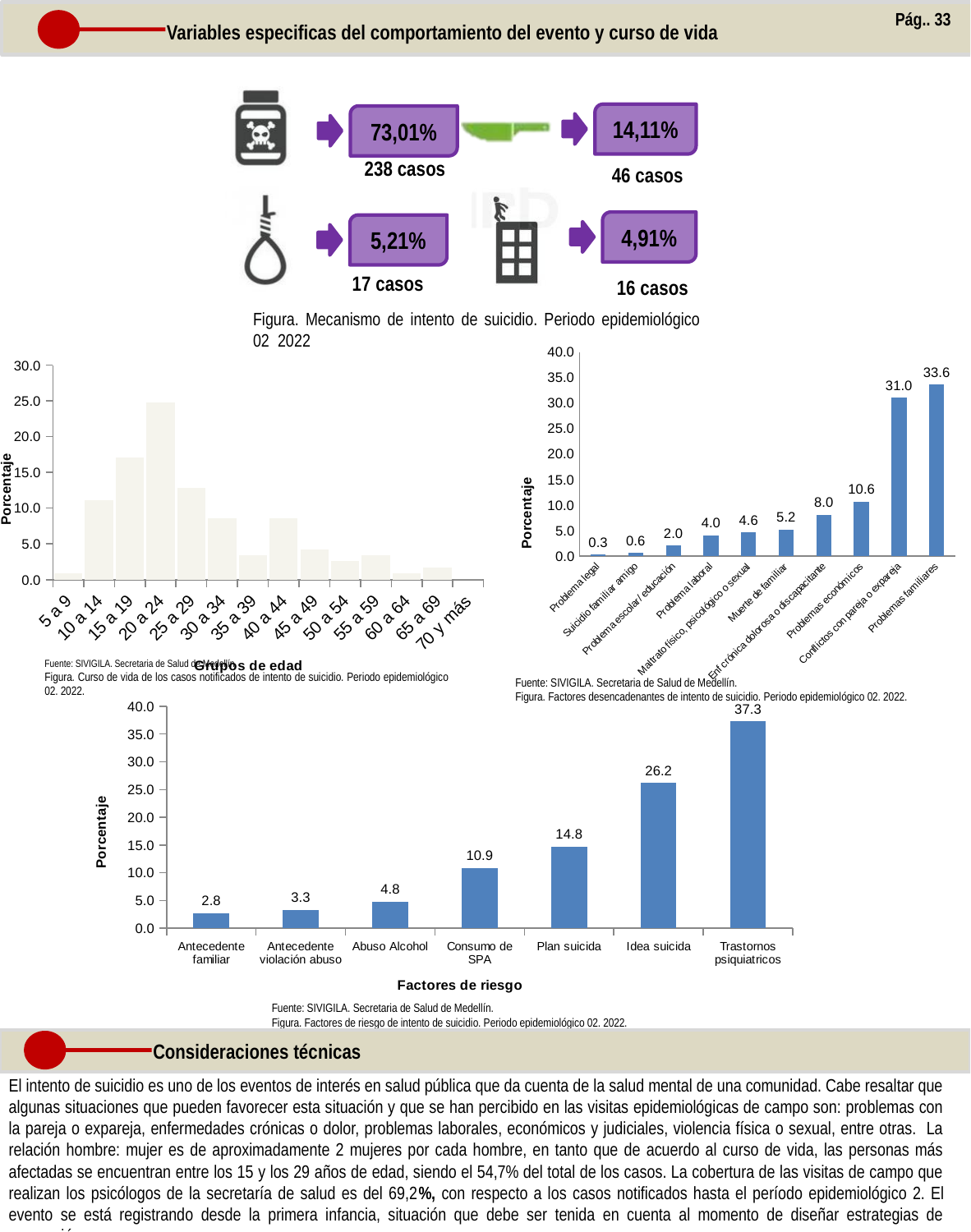
In the chart titled 'Curso de vida de los casos notificados de intento de suicidio' (left), which age group has the highest value? 20 a 24 In the chart titled 'Factores desencadenantes de intento de suicidio' (right), what is the value for 'Problemas familiares'? 33.6 In the chart titled 'Factores desencadenantes de intento de suicidio' (right), what is the value for 'Problemas económicos'? 10.6 In the chart titled 'Factores de riesgo de intento de suicidio' (bottom), which is larger: 'Plan suicida' or 'Abuso Alcohol'? Plan suicida In the chart titled 'Factores de riesgo de intento de suicidio' (bottom), which category has the highest value? Trastornos psiquiatricos In the chart titled 'Factores desencadenantes de intento de suicidio' (right), what is the difference between 'Problemas familiares' and 'Conflictos con pareja o expareja'? 2.6 How many categories are shown in the chart titled 'Factores desencadenantes de intento de suicidio' (right)? 10 In the chart titled 'Factores de riesgo de intento de suicidio' (bottom), what is the value for 'Consumo de SPA'? 10.9 What kind of chart is the chart titled 'Factores de riesgo de intento de suicidio' (bottom)? bar chart In the chart titled 'Factores de riesgo de intento de suicidio' (bottom), what is the difference between 'Trastornos psiquiatricos' and 'Idea suicida'? 11.1 In the chart titled 'Curso de vida de los casos notificados de intento de suicidio' (left), is the value for '15 a 19' greater or less than 15.0? greater In the chart titled 'Factores desencadenantes de intento de suicidio' (right), which category has the lowest value? Problema legal